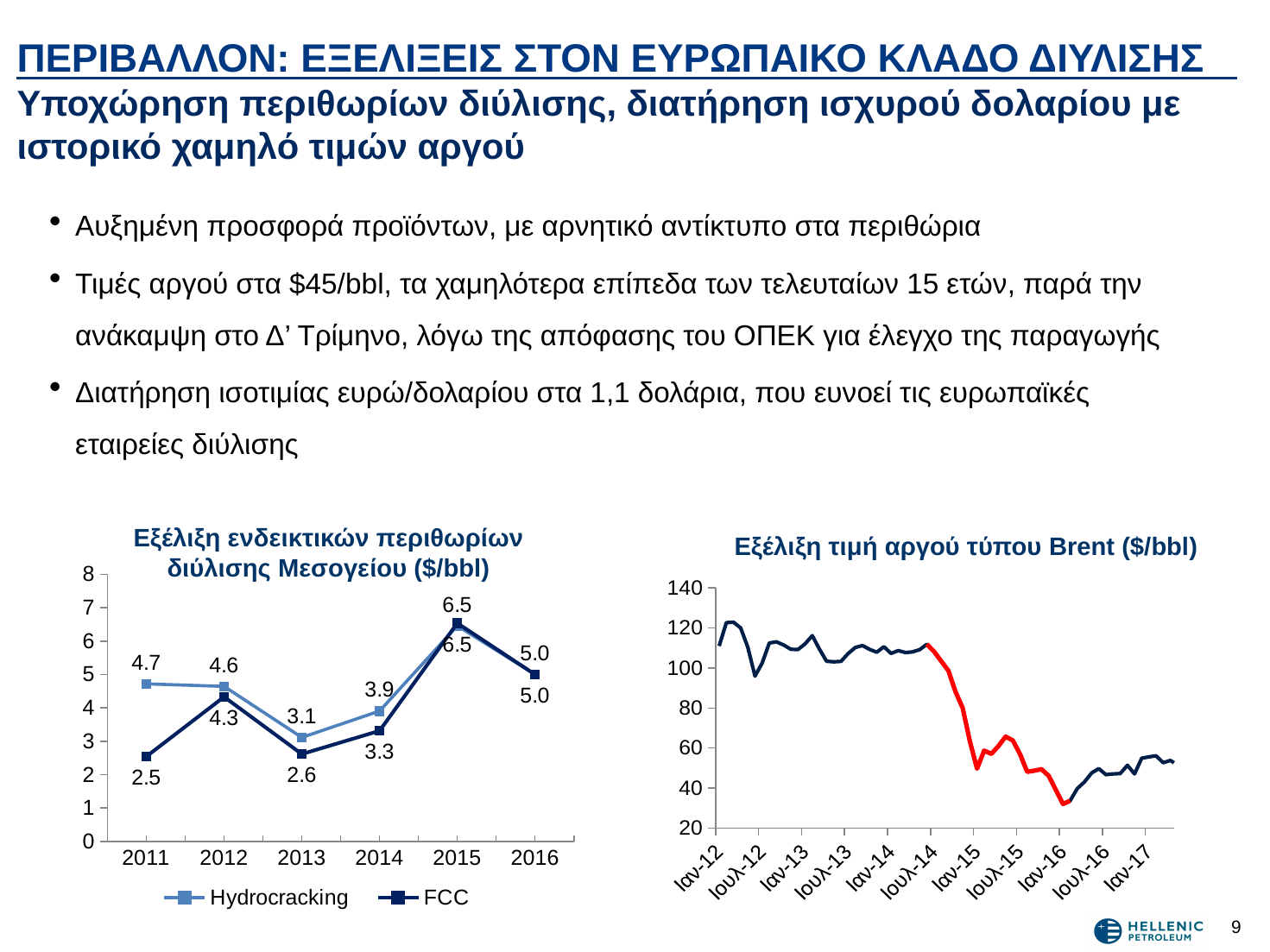
In the chart 'Εξέλιξη ενδεικτικών περιθωρίων διύλισης Μεσογείου ($/bbl)', how many series does the legend list? 2 In the chart 'Εξέλιξη τιμή αργού τύπου Brent ($/bbl)', is the value at Ιαν-14 greater or less than 100? greater In the chart 'Εξέλιξη τιμή αργού τύπου Brent ($/bbl)', does the value rise or fall between Ιουλ-14 and Ιαν-15? fall What kind of chart is 'Εξέλιξη τιμή αργού τύπου Brent ($/bbl)'? line chart In the chart 'Εξέλιξη ενδεικτικών περιθωρίων διύλισης Μεσογείου ($/bbl)', what is the FCC value for 2013? 2.6 In the chart 'Εξέλιξη ενδεικτικών περιθωρίων διύλισης Μεσογείου ($/bbl)', what is the difference between the Hydrocracking and FCC values in 2011? 2.2 In the chart 'Εξέλιξη ενδεικτικών περιθωρίων διύλισης Μεσογείου ($/bbl)', in which year is the FCC value lowest? 2011 In the chart 'Εξέλιξη ενδεικτικών περιθωρίων διύλισης Μεσογείου ($/bbl)', in which year is the Hydrocracking value highest? 2015 In the chart 'Εξέλιξη τιμή αργού τύπου Brent ($/bbl)', is the value at Ιαν-16 greater or less than 40? less In the chart 'Εξέλιξη ενδεικτικών περιθωρίων διύλισης Μεσογείου ($/bbl)', how many years are shown on the x axis? 6 In the chart 'Εξέλιξη ενδεικτικών περιθωρίων διύλισης Μεσογείου ($/bbl)', which series has the larger value in 2014, Hydrocracking or FCC? Hydrocracking In the chart 'Εξέλιξη ενδεικτικών περιθωρίων διύλισης Μεσογείου ($/bbl)', what is the Hydrocracking value for 2011? 4.7